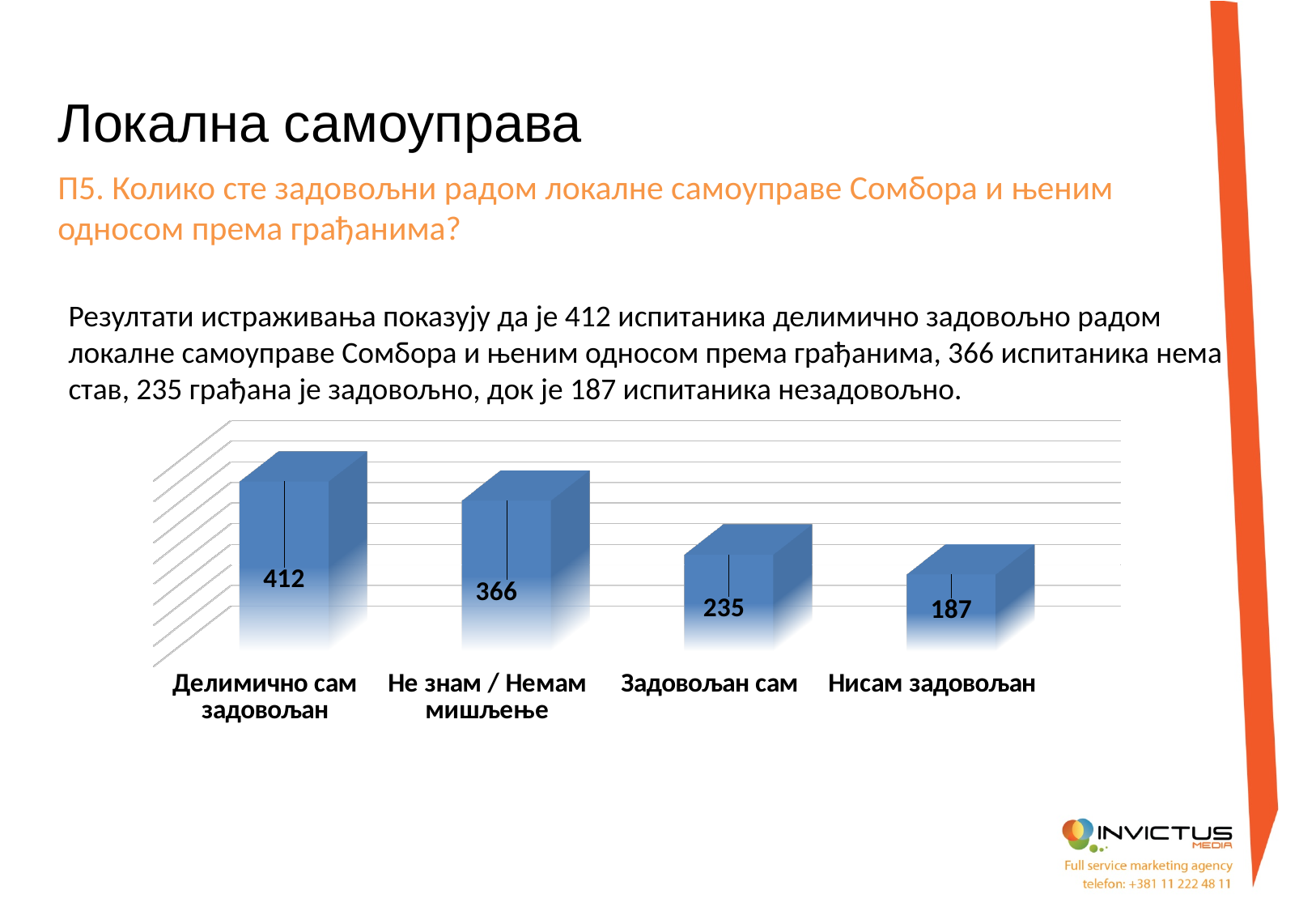
What is the value for "Не знам / Немам мишљење"? 366 Which is larger, the value for "Задовољан сам" or the value for "Нисам задовољан"? Задовољан сам What is the value for "Делимично сам задовољан"? 412 Do the values rise or fall from left to right across the categories? Fall Which category has the lowest value? Нисам задовољан Which category has the highest value? Делимично сам задовољан What is the difference between the values for "Делимично сам задовољан" and "Нисам задовољан"? 225 How many categories are shown in the chart? 4 What is the value for "Задовољан сам"? 235 What is the value for "Нисам задовољан"? 187 What kind of chart is shown on the slide? Bar chart What is the difference between the values for "Не знам / Немам мишљење" and "Задовољан сам"? 131